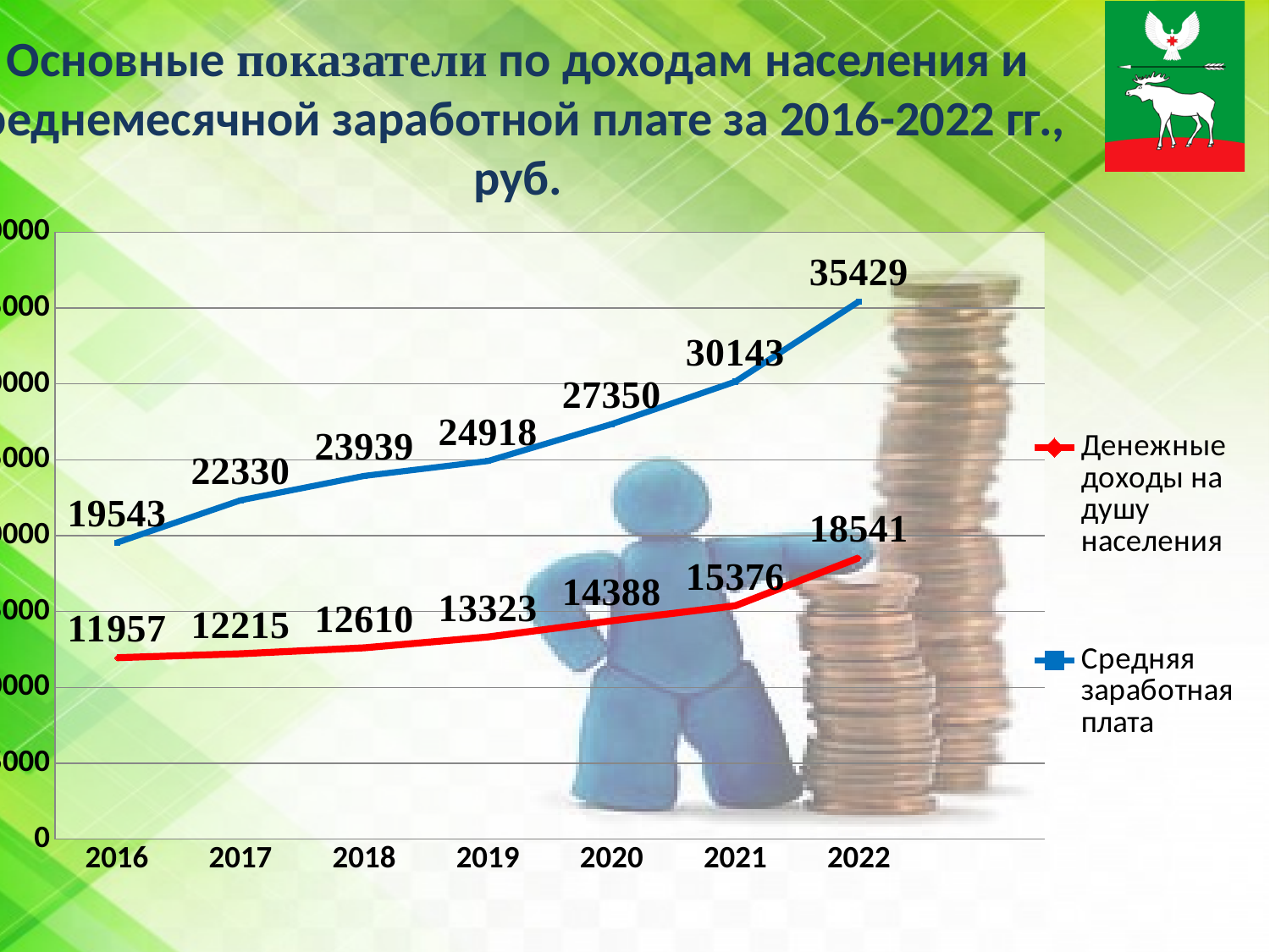
What is the difference between Средняя заработная плата and Денежные доходы на душу населения in 2022? 16888 Does Средняя заработная плата rise or fall from 2016 to 2022? Rise What type of chart is shown on the slide? Line chart Which is larger in 2020: Средняя заработная плата or Денежные доходы на душу населения? Средняя заработная плата What is the value of Денежные доходы на душу населения in 2016? 11957 In which year is Средняя заработная плата the lowest? 2016 What is the value of Средняя заработная плата in 2022? 35429 How many series does the legend list? 2 How many years are shown on the x axis? 7 What is the value of Денежные доходы на душу населения in 2021? 15376 What is the value of Средняя заработная плата in 2019? 24918 In which year is Денежные доходы на душу населения the highest? 2022